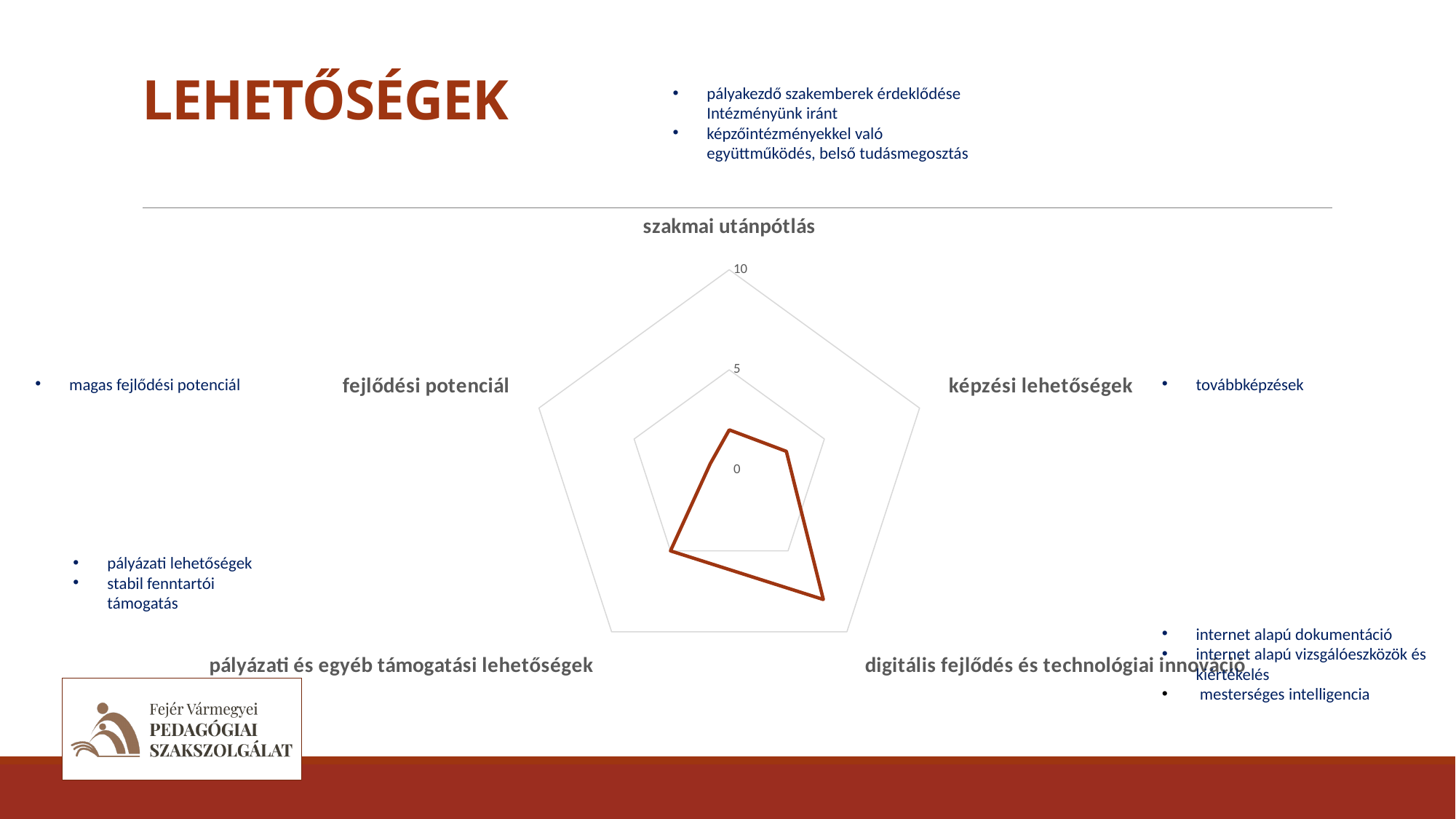
Is the value for szakmai utánpótlás greater or less than 5? less Which category has the lowest value on the radar chart? fejlődési potenciál Which is larger: the value for digitális fejlődés és technológiai innováció or the value for szakmai utánpótlás? digitális fejlődés és technológiai innováció Is the value for digitális fejlődés és technológiai innováció greater or less than 5? greater Which is larger: the value for pályázati és egyéb támogatási lehetőségek or the value for képzési lehetőségek? pályázati és egyéb támogatási lehetőségek How many categories (axes) does the radar chart have? 5 Which category label appears at the top of the radar chart? szakmai utánpótlás Is the value for képzési lehetőségek greater or less than 5? less Which category has the highest value on the radar chart? digitális fejlődés és technológiai innováció What kind of chart is shown on the slide? radar chart What is the maximum value shown on the radar chart's scale? 10